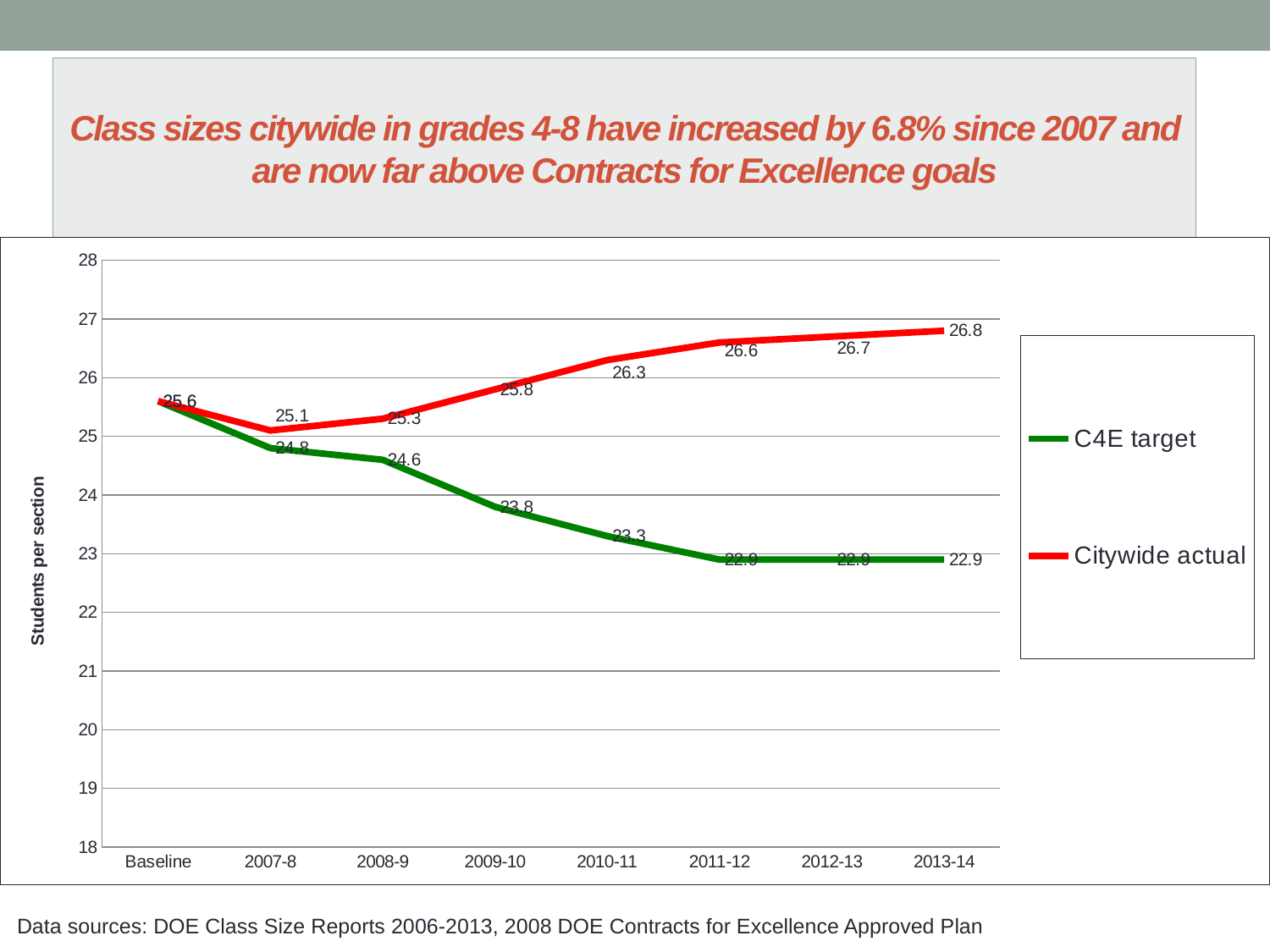
Which is larger in 2012-13, the Citywide actual value or the C4E target value? Citywide actual How many series does the legend list? 2 What is the Citywide actual value for 2013-14? 26.8 What is the difference between the Citywide actual and C4E target values in 2013-14? 3.9 In which year is the Citywide actual value lowest? 2007-8 What is the C4E target value for 2008-9? 24.6 Does the C4E target line rise or fall from Baseline to 2013-14? Fall In which year is the Citywide actual value highest? 2013-14 What is the C4E target value for 2013-14? 22.9 What kind of chart is shown on the slide? Line chart What is the Citywide actual value for 2010-11? 26.3 How many points are plotted along the x axis for each series? 8